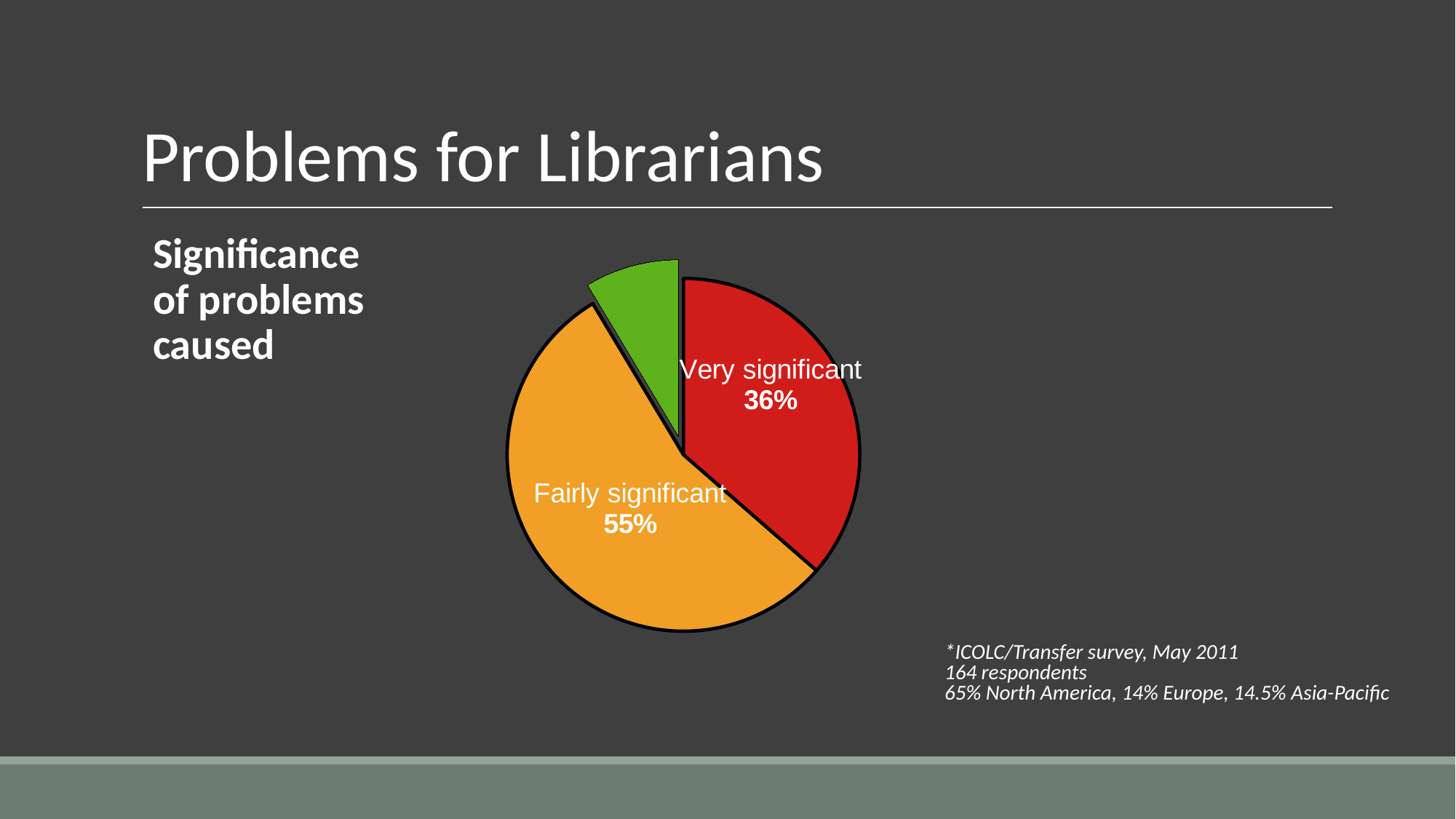
Which is larger, the "Very significant" slice or the "Fairly significant" slice? Fairly significant What colour is the "Very significant" slice? red What is the value shown for the "Fairly significant" slice? 55% What kind of chart is shown on the slide? pie chart What is the difference in percentage points between the "Fairly significant" and "Very significant" slices? 19 What share of the pie is labelled "Very significant"? 36% Which labelled slice is the largest in the pie chart? Fairly significant How many slices does the pie chart have? 3 What share of the pie is labelled "Fairly significant"? 55% What is the value shown for the "Very significant" slice? 36% What is the heading shown to the left of the pie chart? Significance of problems caused